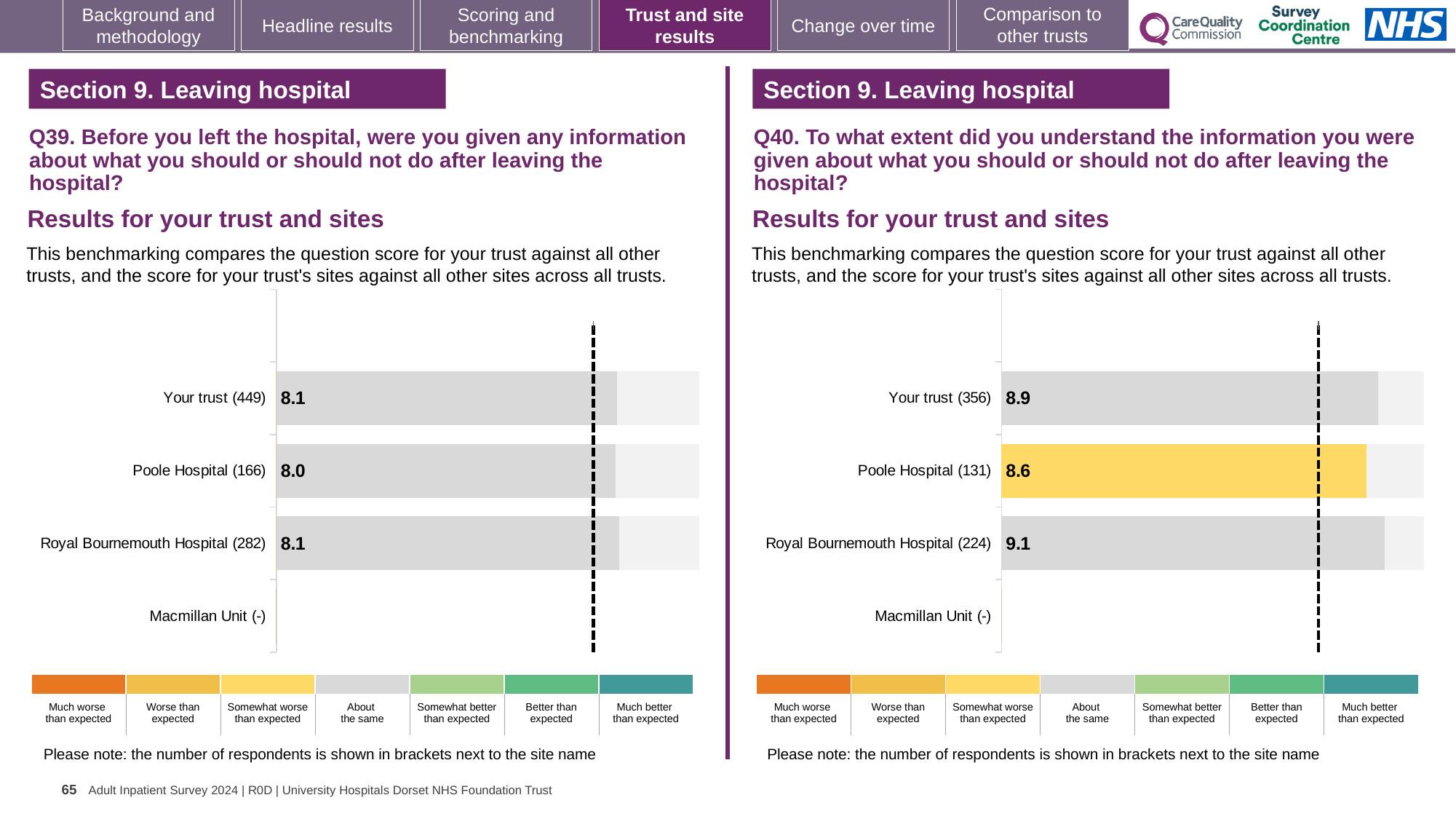
In the Q40 chart on the right, which site's bar is coloured yellow (somewhat worse than expected)? Poole Hospital In the Q40 chart on the right, which site has the highest score? Royal Bournemouth Hospital In the Q40 chart on the right, what is the score for Poole Hospital? 8.6 In the Q40 chart on the right, what is the score for Royal Bournemouth Hospital? 9.1 In the Q39 chart on the left, what is the difference between the scores for Your trust and Poole Hospital? 0.1 In the Q39 chart on the left, what is the score for Poole Hospital? 8.0 How many respondents are shown in brackets for Your trust in the Q39 chart on the left? 449 In the Q40 chart on the right, what is the difference between the scores for Royal Bournemouth Hospital and Poole Hospital? 0.5 What type of chart is used in the Q40 chart on the right? Bar chart In the Q39 chart on the left, what is the score for Your trust? 8.1 In the Q40 chart on the right, which site has the lowest score among those with a score shown? Poole Hospital In the Q40 chart on the right, which has a higher score, Your trust or Poole Hospital? Your trust